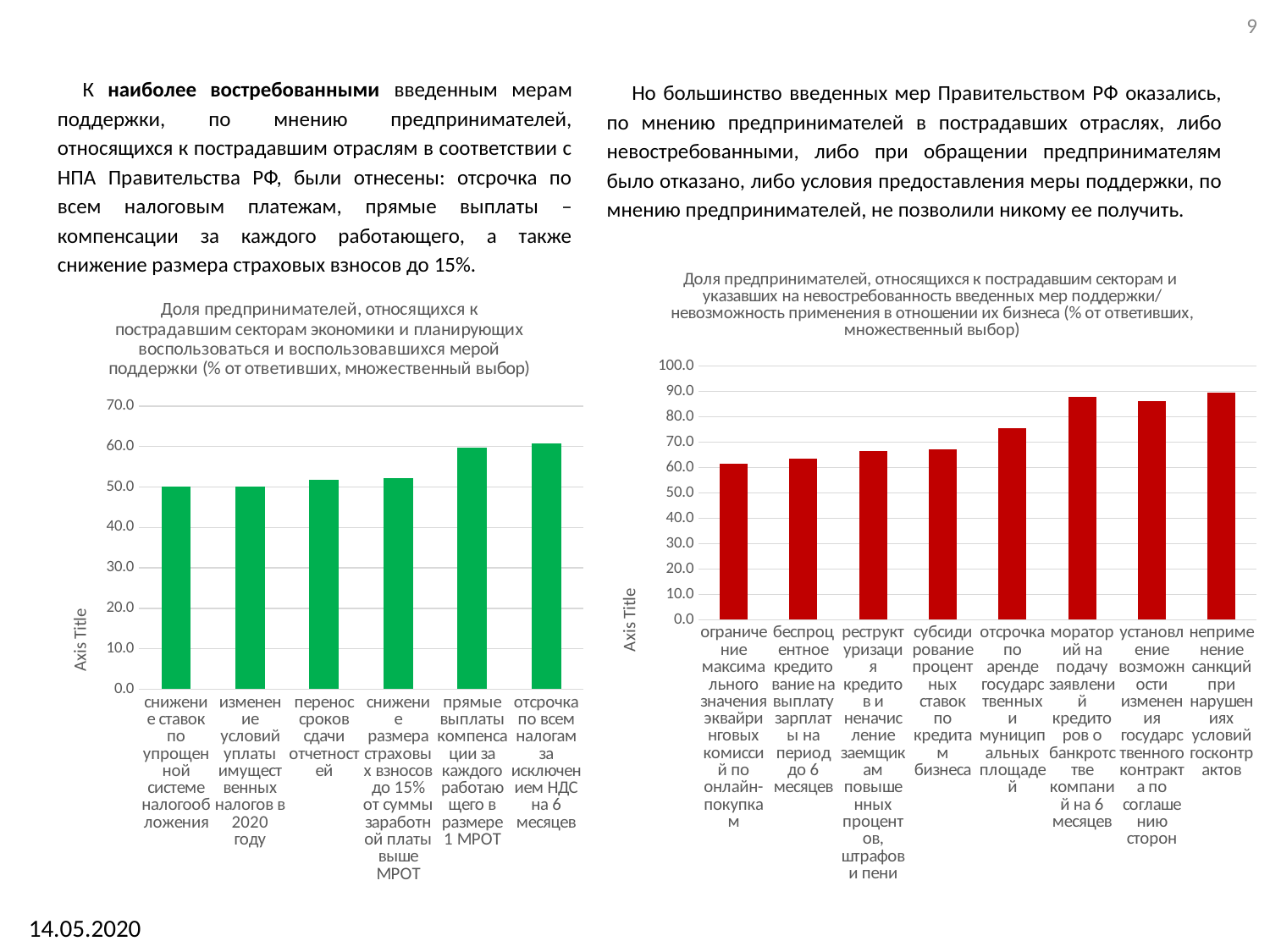
What kind of chart is the left chart, titled 'Доля предпринимателей, относящихся к пострадавшим секторам экономики и планирующих воспользоваться и воспользовавшихся мерой поддержки'? bar chart In the right chart, is the value for 'субсидирование процентных ставок по кредитам бизнеса' greater or less than 70? less In the left chart, do the values generally rise or fall from left to right along the x axis? rise In the left chart, is the value for 'прямые выплаты компенсации за каждого работающего в размере 1 МРОТ' greater or less than 50? greater How many categories are plotted in the left chart? 6 In the left chart, is the value for 'перенос сроков сдачи отчетности' greater or less than 40? greater What colour are the bars in the right chart? red How many categories are plotted in the right chart, titled 'Доля предпринимателей ... указавших на невостребованность введенных мер поддержки'? 8 In the right chart, which is larger: the value for 'отсрочка по аренде государственных и муниципальных площадей' or the value for 'беспроцентное кредитование на выплату зарплаты на период до 6 месяцев'? отсрочка по аренде государственных и муниципальных площадей In the left chart, which is larger: the value for 'прямые выплаты компенсации за каждого работающего в размере 1 МРОТ' or the value for 'изменение условий уплаты имущественных налогов в 2020 году'? прямые выплаты компенсации за каждого работающего в размере 1 МРОТ